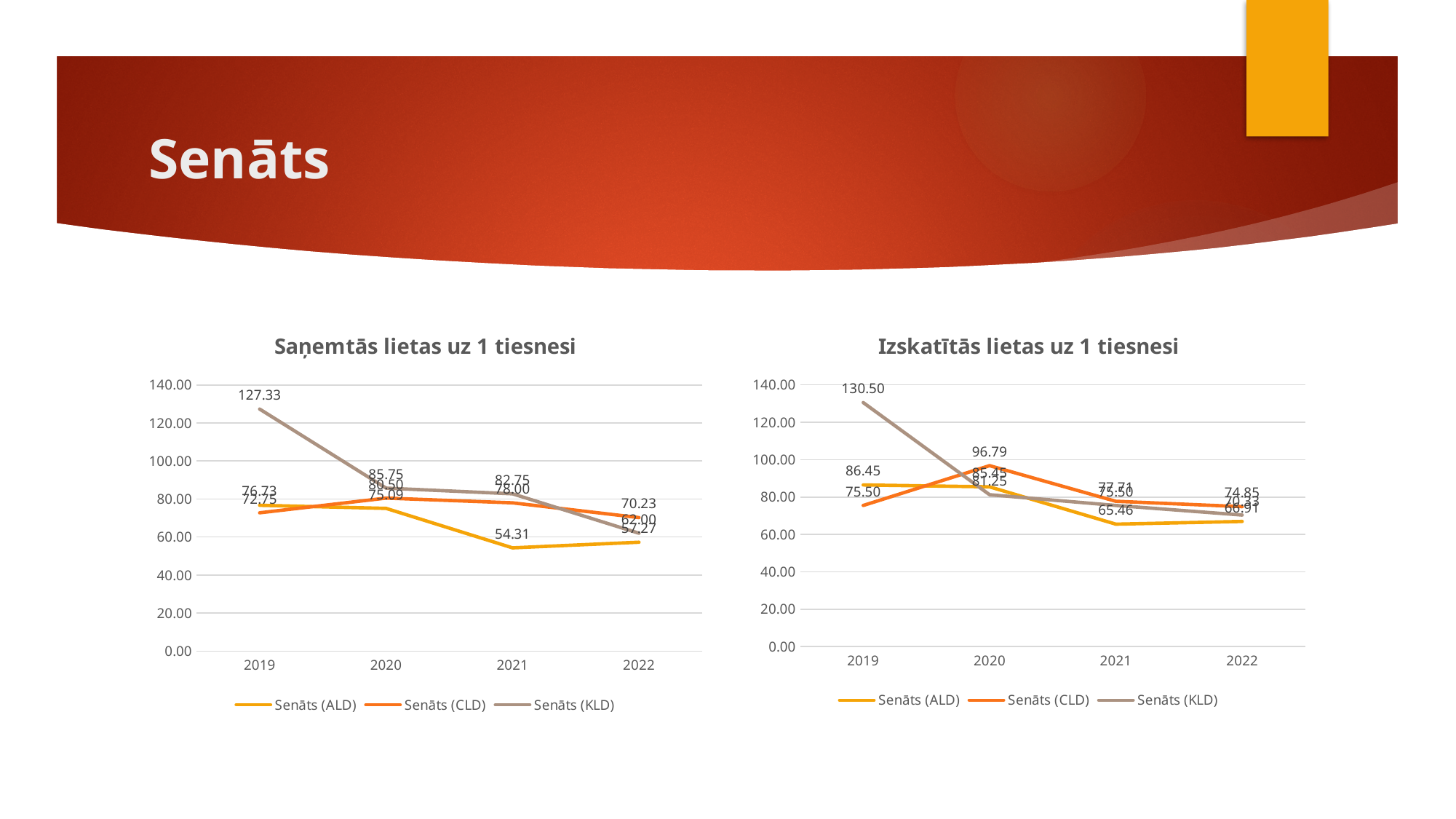
How many series does the legend of the chart titled "Izskatītās lietas uz 1 tiesnesi" list? 3 In the chart titled "Saņemtās lietas uz 1 tiesnesi", what is the value for Senāts (KLD) in 2019? 127.33 In the chart titled "Saņemtās lietas uz 1 tiesnesi", what is the value for Senāts (ALD) in 2021? 54.31 What kind of chart is "Saņemtās lietas uz 1 tiesnesi"? line chart In the chart titled "Saņemtās lietas uz 1 tiesnesi", does the Senāts (KLD) line rise or fall from 2019 to 2022? fall In the chart titled "Izskatītās lietas uz 1 tiesnesi", what is the value for Senāts (KLD) in 2019? 130.50 In the chart titled "Izskatītās lietas uz 1 tiesnesi", which is larger: Senāts (ALD) in 2019 or Senāts (ALD) in 2021? Senāts (ALD) in 2019 In the chart titled "Saņemtās lietas uz 1 tiesnesi", which series has the highest value in 2019? Senāts (KLD) In the chart titled "Saņemtās lietas uz 1 tiesnesi", in which year is the Senāts (ALD) value lowest? 2021 In the chart titled "Saņemtās lietas uz 1 tiesnesi", what is the difference between the Senāts (KLD) values for 2019 and 2020? 41.58 How many years are shown on the x axis of the chart titled "Izskatītās lietas uz 1 tiesnesi"? 4 In the chart titled "Izskatītās lietas uz 1 tiesnesi", what is the value for Senāts (CLD) in 2020? 96.79